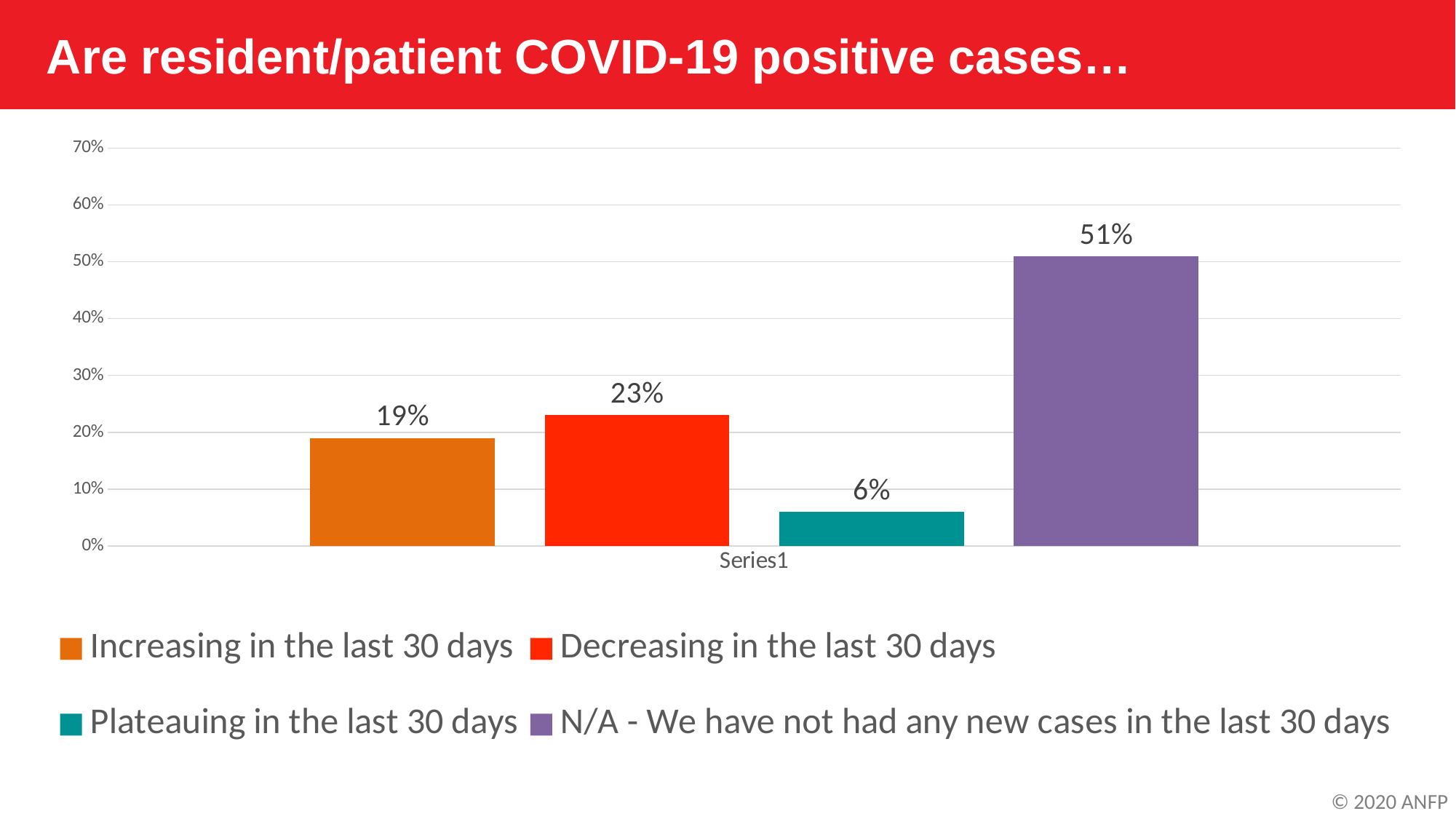
What percentage of respondents reported COVID-19 positive cases plateauing in the last 30 days? 6% Which response has the highest percentage? N/A - We have not had any new cases in the last 30 days Which is larger: the percentage for 'Increasing in the last 30 days' or 'Decreasing in the last 30 days'? Decreasing in the last 30 days What is the difference in percentage points between 'Decreasing in the last 30 days' and 'Increasing in the last 30 days'? 4 percentage points What percentage of respondents reported COVID-19 positive cases decreasing in the last 30 days? 23% How many bars are shown in the chart? 4 What percentage of respondents reported COVID-19 positive cases increasing in the last 30 days? 19% Is the value for 'N/A - We have not had any new cases in the last 30 days' greater or less than 50%? greater What type of chart is shown on the slide? Bar chart Which response has the lowest percentage? Plateauing in the last 30 days What percentage of respondents said they have not had any new cases in the last 30 days? 51% What colour is the bar for 'Plateauing in the last 30 days'? Teal